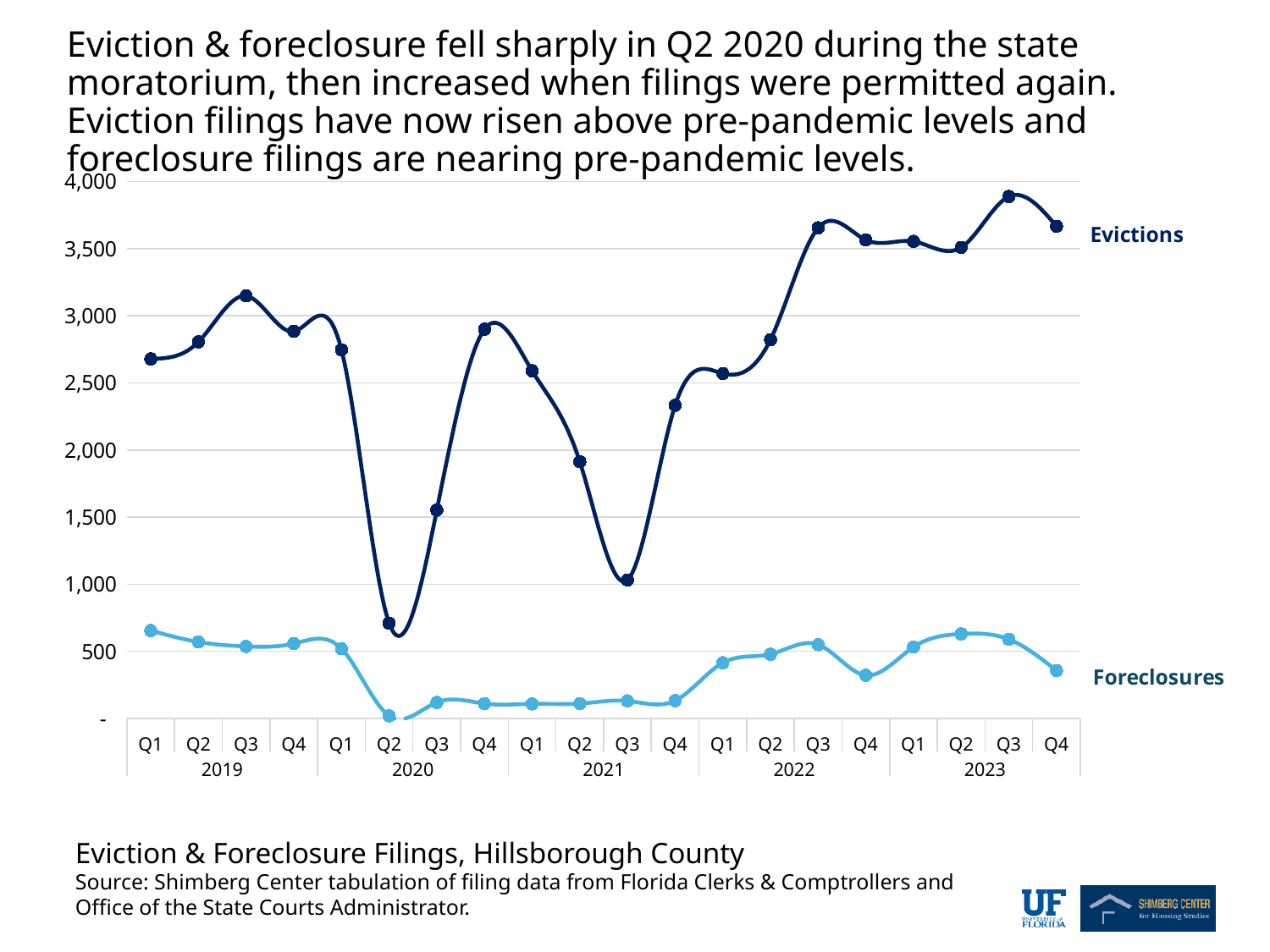
What kind of chart is shown on the slide? Line chart Is the Foreclosures value for Q1 2019 greater or less than 500? greater How many series are plotted on the chart? 2 Which is larger, the Evictions value for Q3 2019 or for Q1 2019? Q3 2019 In which quarter do Evictions reach their highest value? Q3 2023 In which quarter do Evictions reach their lowest value? Q2 2020 What is the title of the chart given below it? Eviction & Foreclosure Filings, Hillsborough County In which quarter do Foreclosures reach their lowest value? Q2 2020 How many quarterly data points does each line have? 20 Is the Evictions value for Q2 2020 greater or less than 1,000? less Do Evictions rise or fall from Q1 2022 to Q3 2022? Rise Is the Evictions value for Q3 2023 greater or less than 3,500? greater